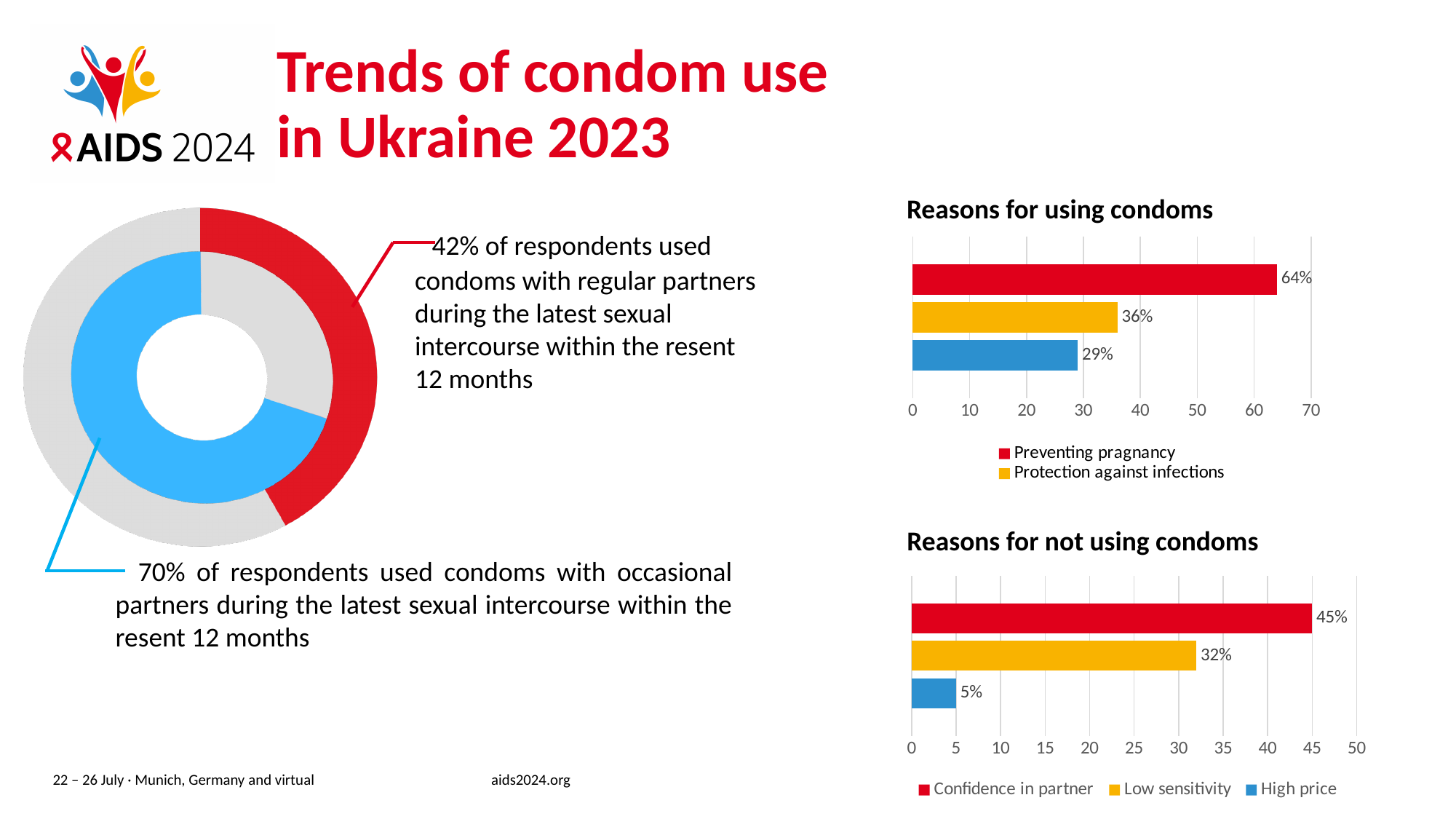
In the 'Reasons for not using condoms' chart, how many series does the legend list? 3 In the 'Reasons for using condoms' chart, what is the value shown on the blue bar? 29% What kind of chart is the 'Reasons for not using condoms' chart? Bar chart In the 'Reasons for not using condoms' chart, what is the value for Confidence in partner? 45% In the 'Reasons for not using condoms' chart, what is the difference between Low sensitivity and High price? 27% In the 'Reasons for not using condoms' chart, which reason has the lowest value? High price In the 'Reasons for using condoms' chart, what is the difference between Preventing pregnancy and Protection against infections? 28% In the 'Reasons for not using condoms' chart, which reason has the highest value? Confidence in partner In the doughnut chart on the left, what share of respondents used condoms with occasional partners during the latest sexual intercourse? 70% In the 'Reasons for not using condoms' chart, what is the value for High price? 5% In the 'Reasons for using condoms' chart, what is the value for Preventing pregnancy? 64% In the 'Reasons for using condoms' chart, what is the value for Protection against infections? 36%